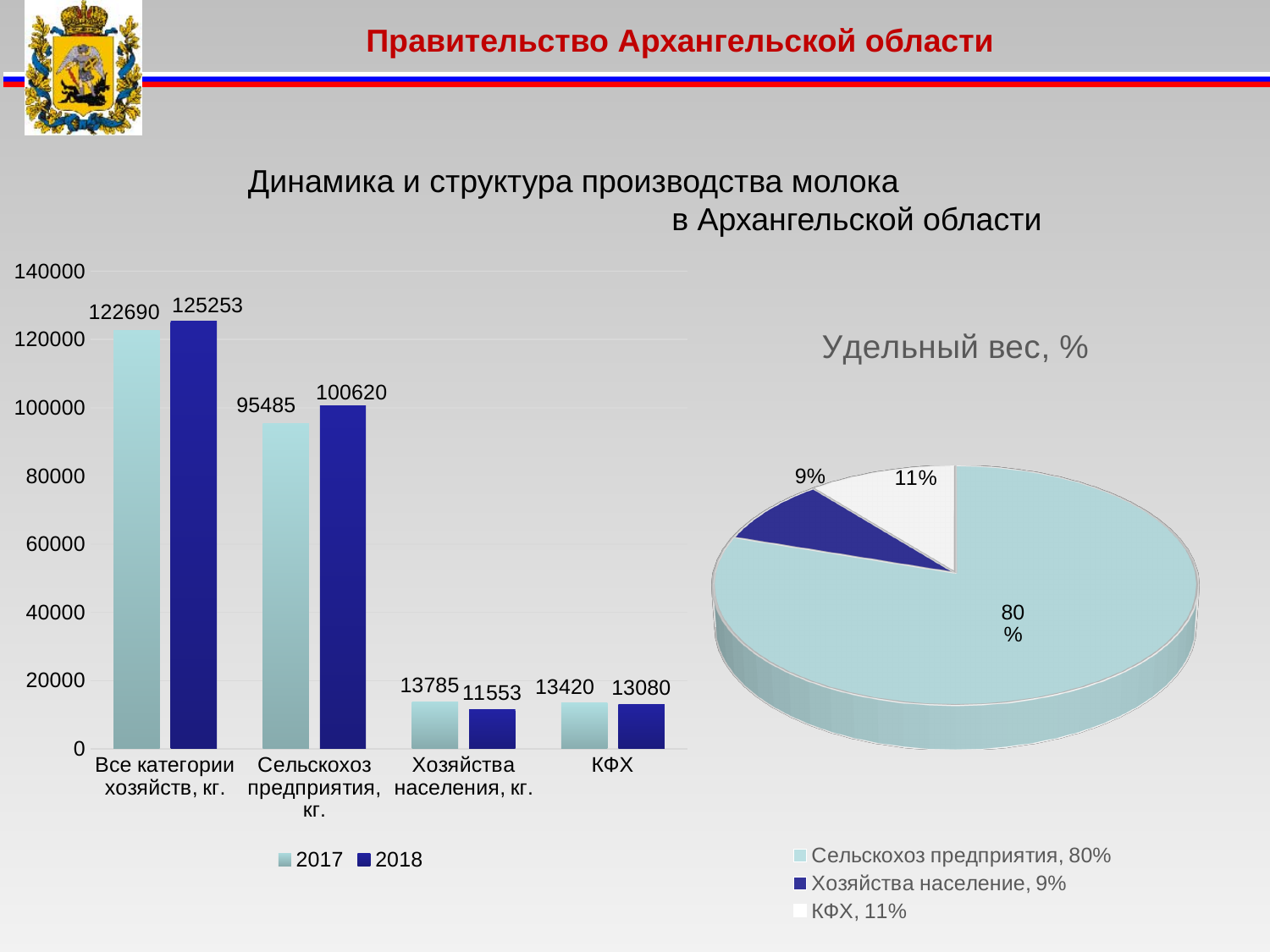
On the bar chart on the left, what is the 2017 value for КФХ? 13420 On the bar chart on the left, how many series does the legend list? 2 On the bar chart on the left, what is the 2018 value for Все категории хозяйств, кг.? 125253 On the bar chart on the left, how many categories are shown on the x axis? 4 On the bar chart on the left, what is the 2017 value for Сельскохоз предприятия, кг.? 95485 On the pie chart titled Удельный вес, %, which slice is the smallest? Хозяйства население On the bar chart on the left, which is larger for Хозяйства населения, кг.: the 2017 value or the 2018 value? 2017 What kind of chart is the chart titled Удельный вес, %? Pie chart On the bar chart on the left, what is the difference between the 2018 and 2017 values for Сельскохоз предприятия, кг.? 5135 On the pie chart titled Удельный вес, %, what share does Сельскохоз предприятия have? 80% On the bar chart on the left, what is the 2018 value for Хозяйства населения, кг.? 11553 On the bar chart on the left, which category has the lowest 2018 value? Хозяйства населения, кг.